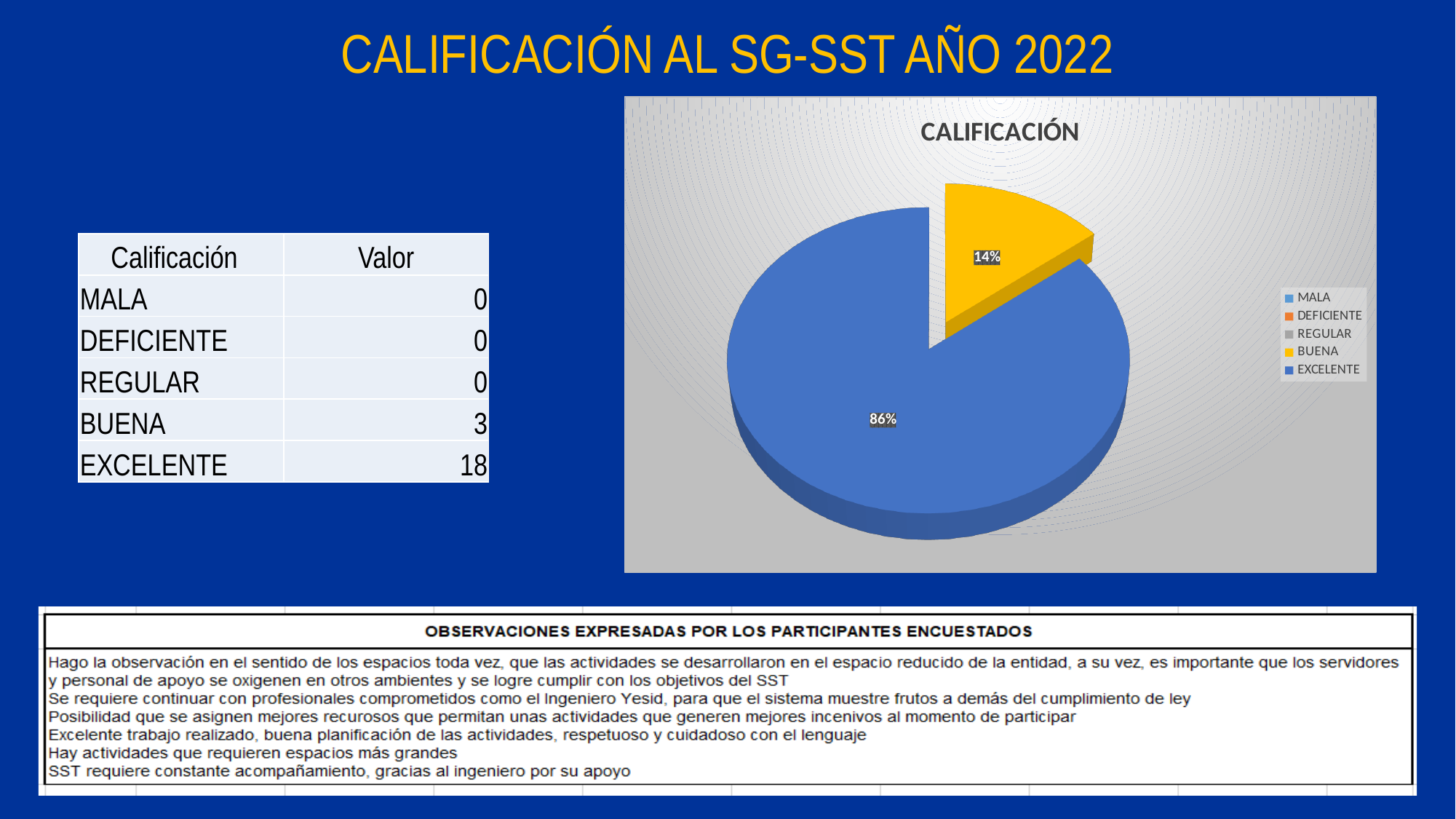
What is the difference in percentage points between the EXCELENTE slice and the BUENA slice? 72% What share of the pie does the EXCELENTE slice represent? 86% Which slice is larger, BUENA or EXCELENTE? EXCELENTE What kind of chart is shown on the slide? pie chart Is the share for EXCELENTE greater or less than 50%? greater How many slices are visible in the pie chart? 2 What colour is the EXCELENTE slice in the pie chart? blue What is the title of the chart? CALIFICACIÓN What share of the pie does the BUENA slice represent? 14% How many entries does the chart legend list? 5 Which category has the largest slice of the pie? EXCELENTE